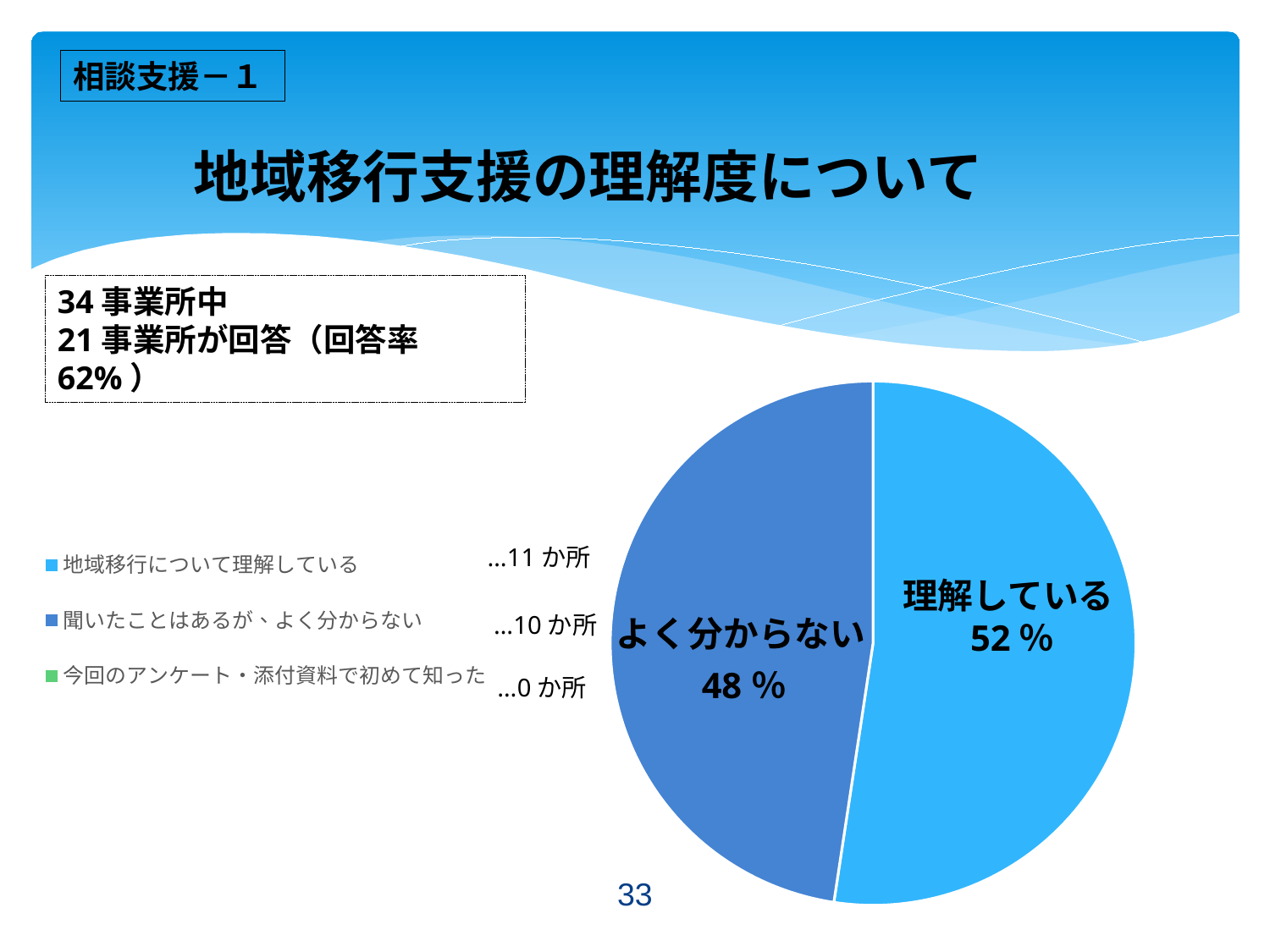
How many 事業所 are listed next to the legend entry 今回のアンケート・添付資料で初めて知った? 0 か所 Which legend category has the lowest count? 今回のアンケート・添付資料で初めて知った How many 事業所 are listed next to the legend entry 聞いたことはあるが、よく分からない? 10 か所 What is the title of the slide containing the pie chart? 地域移行支援の理解度について How many 事業所 are listed next to the legend entry 地域移行について理解している? 11 か所 What kind of chart is shown on the slide? pie chart Which of the two visible slices is larger, 理解している or よく分からない? 理解している What share of the pie is labelled 理解している? 52 % What share of the pie is labelled よく分からない? 48 % What is the difference in percentage points between the 理解している slice and the よく分からない slice? 4 How many entries does the legend list? 3 Which slice of the pie is the largest? 理解している